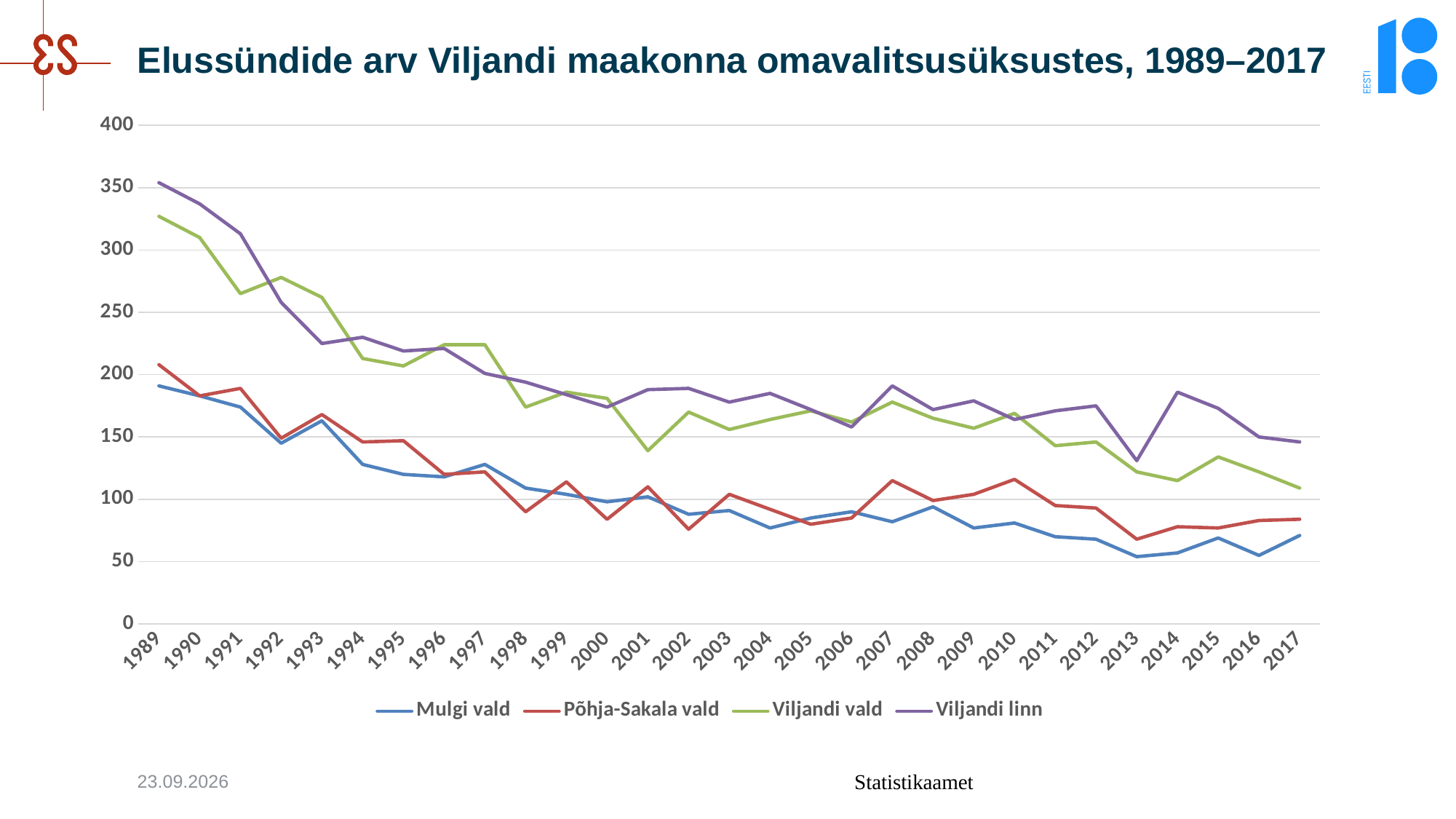
Is the value for Viljandi vald in 1989 greater or less than 300? greater Does the value for Viljandi linn rise or fall from 1989 to 2017? fall Which series has the highest value in 1989? Viljandi linn How many years are plotted along the x axis? 29 Which series has the lowest value in 2017? Mulgi vald How many series does the legend list? 4 In 1989, which is larger: the value for Viljandi linn or the value for Mulgi vald? Viljandi linn Is the value for Viljandi linn in 1989 greater or less than 300? greater What kind of chart is shown on the slide? line chart Is the value for Mulgi vald in 2013 greater or less than 100? less What is the title of the chart? Elussündide arv Viljandi maakonna omavalitsusüksustes, 1989–2017